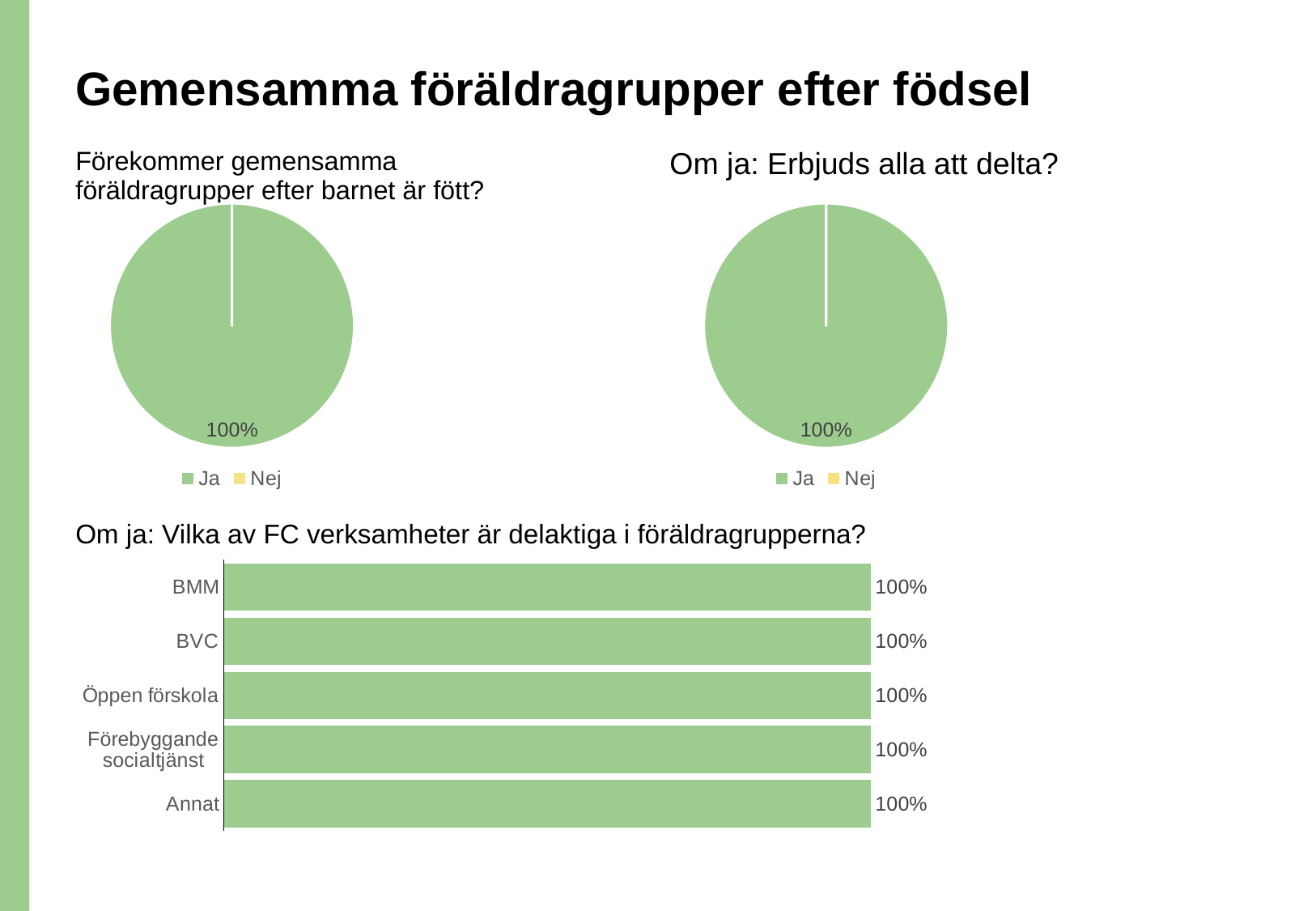
In the chart titled "Förekommer gemensamma föräldragrupper efter barnet är fött?", what kind of chart is shown? Pie chart In the chart titled "Om ja: Vilka av FC verksamheter är delaktiga i föräldragrupperna?", how many categories are shown? 5 In the chart titled "Om ja: Vilka av FC verksamheter är delaktiga i föräldragrupperna?", what is the value for Öppen förskola? 100% In the chart titled "Om ja: Erbjuds alla att delta?", what share of the pie does "Ja" take? 100% In the chart titled "Om ja: Vilka av FC verksamheter är delaktiga i föräldragrupperna?", what is the difference between the values for BMM and Annat? 0% In the chart titled "Om ja: Erbjuds alla att delta?", what are the legend entries? Ja, Nej In the chart titled "Om ja: Erbjuds alla att delta?", what kind of chart is shown? Pie chart In the chart titled "Om ja: Vilka av FC verksamheter är delaktiga i föräldragrupperna?", what is the value for BVC? 100% In the chart titled "Förekommer gemensamma föräldragrupper efter barnet är fött?", what share of the pie does "Ja" take? 100% In the chart titled "Om ja: Vilka av FC verksamheter är delaktiga i föräldragrupperna?", what kind of chart is shown? Bar chart In the chart titled "Förekommer gemensamma föräldragrupper efter barnet är fött?", how many entries does the legend list? 2 In the chart titled "Om ja: Vilka av FC verksamheter är delaktiga i föräldragrupperna?", what is the value for Förebyggande socialtjänst? 100%